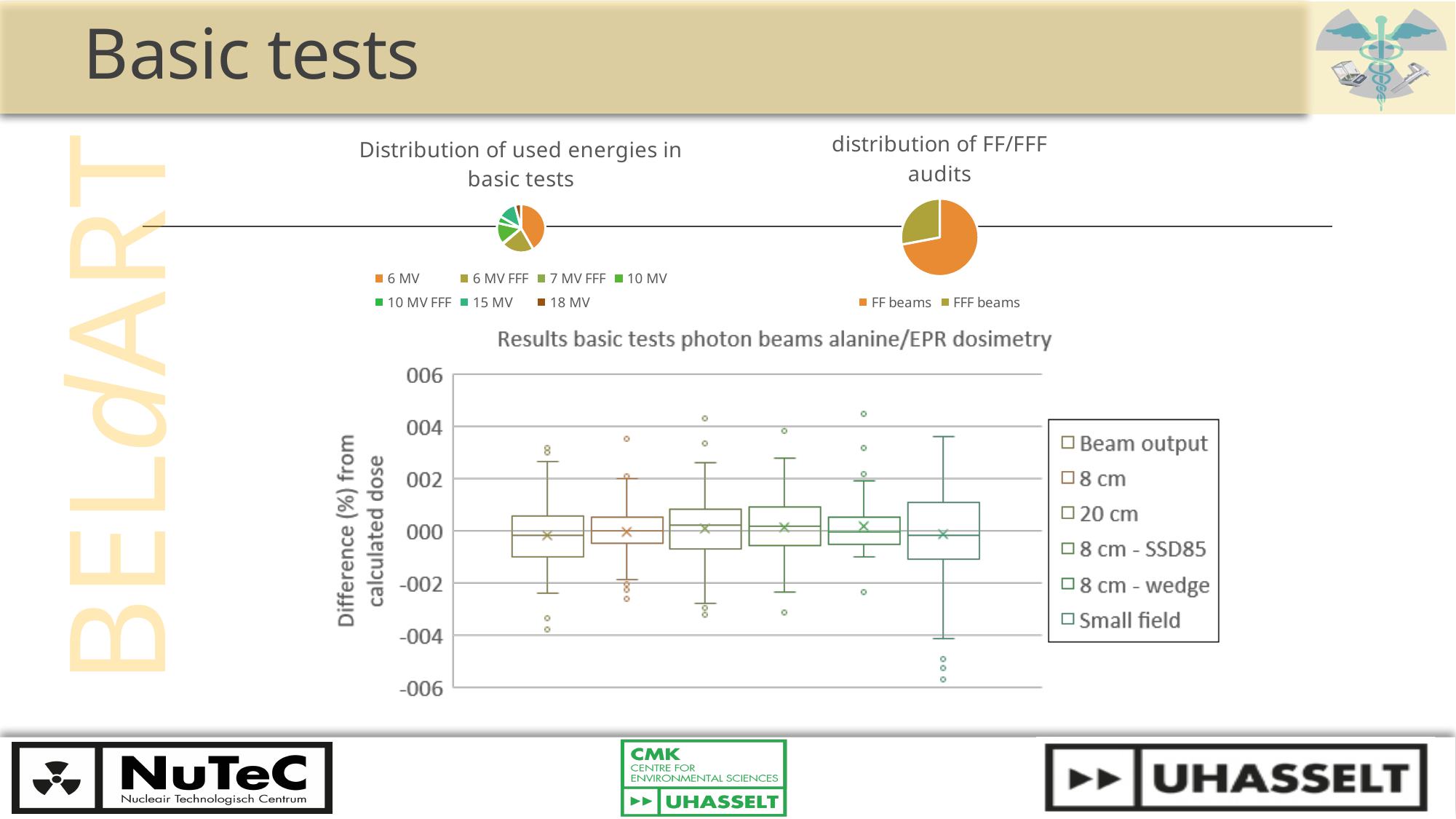
What is the y-axis label of the 'Results basic tests photon beams alanine/EPR dosimetry' chart? Difference (%) from calculated dose What kind of chart is the 'distribution of FF/FFF audits' chart? pie chart How many categories does the legend of the 'distribution of FF/FFF audits' chart list? 2 In the 'Distribution of used energies in basic tests' chart, which energy has the largest slice? 6 MV How many series does the legend of the 'Results basic tests photon beams alanine/EPR dosimetry' chart list? 6 In the 'Results basic tests photon beams alanine/EPR dosimetry' chart, which series has the widest box (largest interquartile range)? Small field What kind of chart is 'Results basic tests photon beams alanine/EPR dosimetry'? box plot In the 'distribution of FF/FFF audits' chart, which category has the larger slice, FF beams or FFF beams? FF beams How many categories does the legend of the 'Distribution of used energies in basic tests' chart list? 7 In the 'Results basic tests photon beams alanine/EPR dosimetry' chart, is the highest outlier for 8 cm - wedge greater or less than 004? greater What kind of chart is the 'Distribution of used energies in basic tests' chart? pie chart In the 'Results basic tests photon beams alanine/EPR dosimetry' chart, is the lowest outlier for Small field greater or less than -004? less